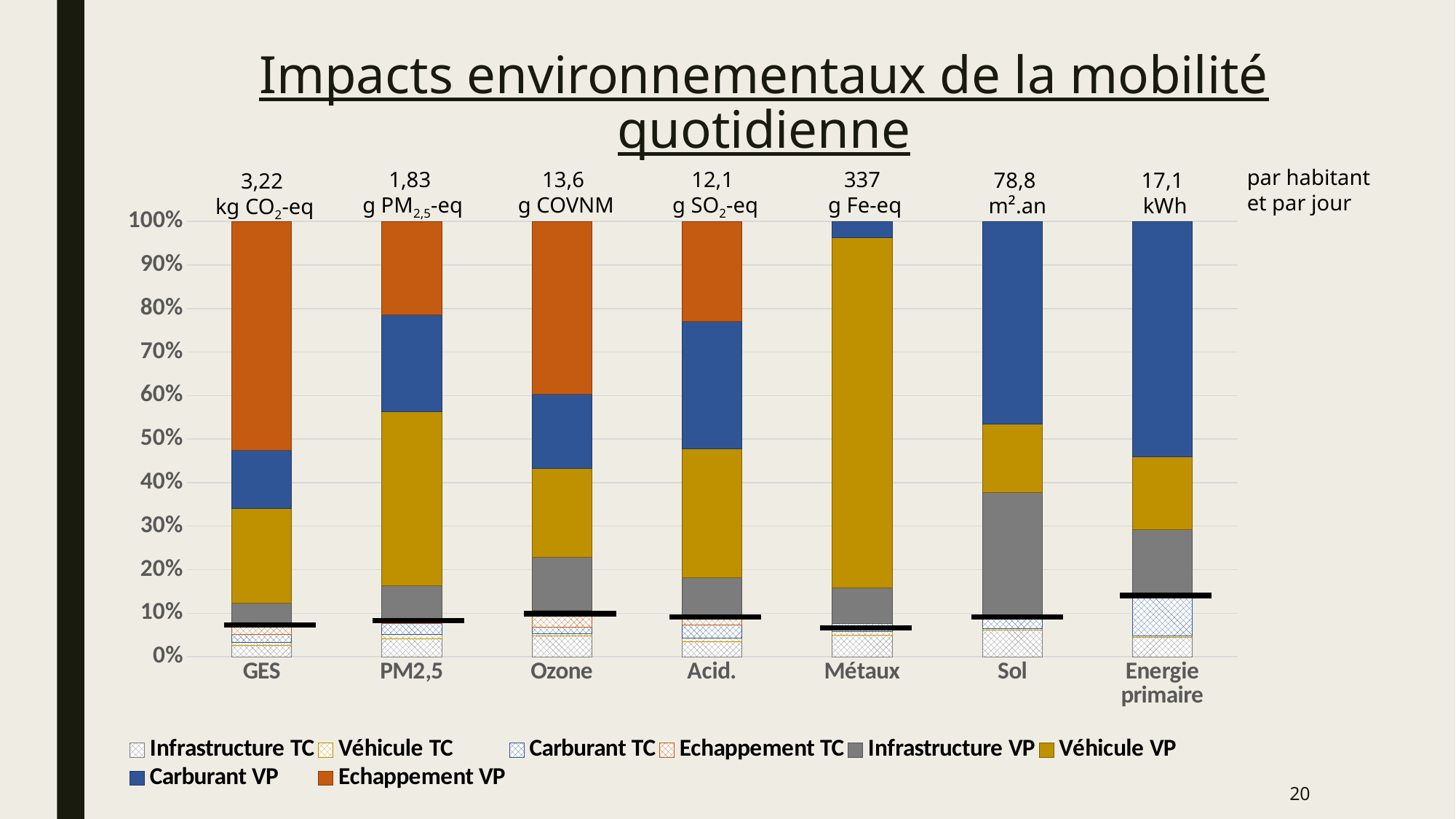
What is the title of the chart on the slide? Impacts environnementaux de la mobilité quotidienne What total value is printed above the GES bar? 3,22 kg CO2-eq Is the Véhicule VP share of the Métaux bar greater or less than 70%? greater Which category has the largest Infrastructure VP share? Sol What total value is printed above the Sol bar? 78,8 m².an How many impact categories are shown along the x axis? 7 How many series does the legend list? 8 What kind of chart is shown on the slide? Stacked bar chart What total value is printed above the Energie primaire bar? 17,1 kWh What total value is printed above the Métaux bar? 337 g Fe-eq Which category has the largest Echappement VP share? GES Is the Echappement VP share of the GES bar greater or less than 50%? greater